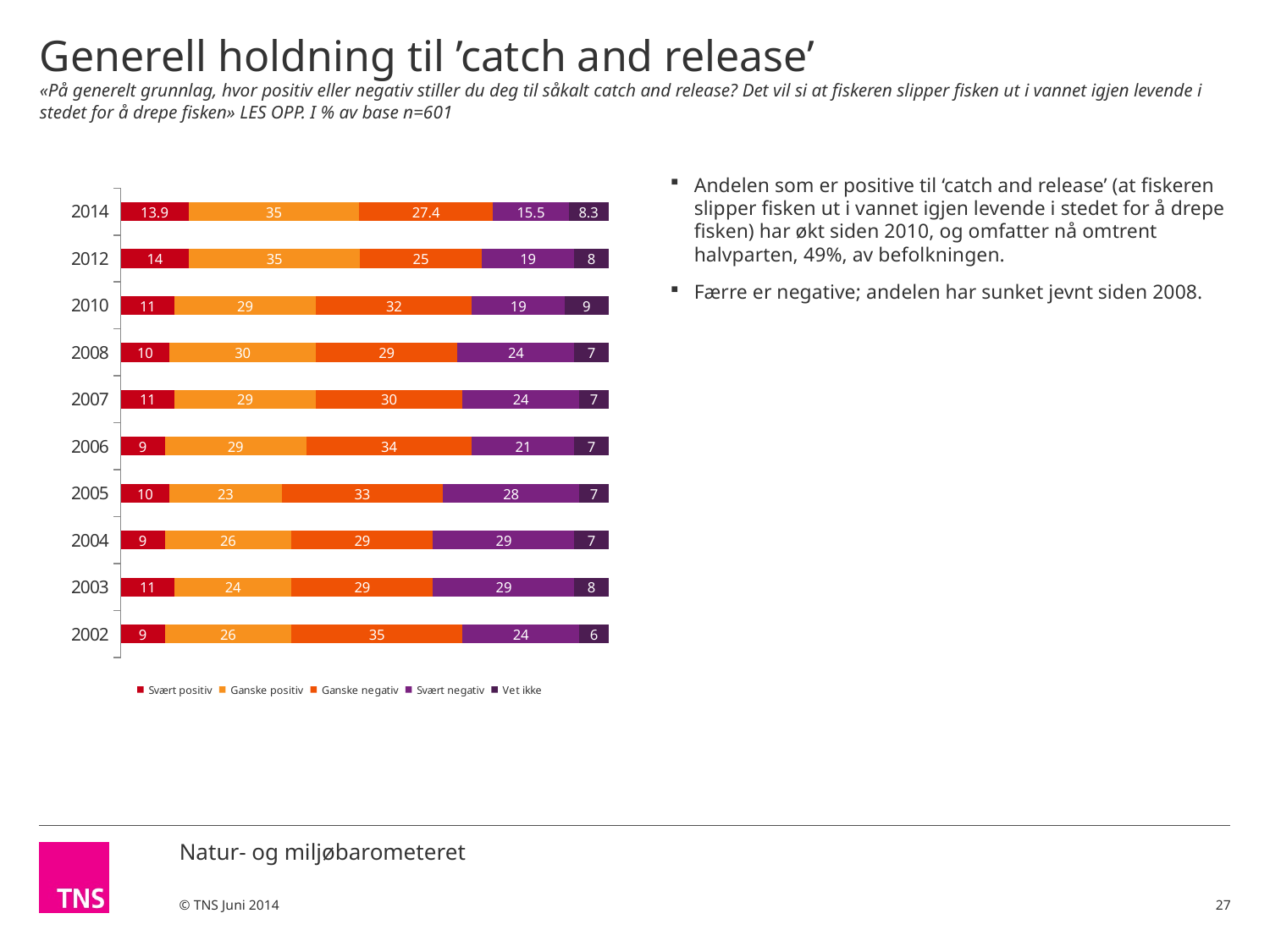
Which is larger: the 'Svært negativ' value in 2012 or in 2008? 2008 How many years (categories) are shown on the chart? 10 Which year has the highest value for 'Svært negativ'? 2004 and 2003 (29) Which year has the lowest value for 'Vet ikke'? 2002 What is the value for 'Ganske negativ' in 2010? 32 What is the value for 'Vet ikke' in 2002? 6 How many series does the chart legend list? 5 What is the total of the 'Svært positiv' and 'Ganske positiv' values for 2012? 49 What kind of chart is shown on the slide? Stacked bar chart What is the value for 'Svært negativ' in 2005? 28 What is the value for 'Svært positiv' in 2014? 13.9 What is the difference between the 'Ganske positiv' values for 2014 and 2005? 12